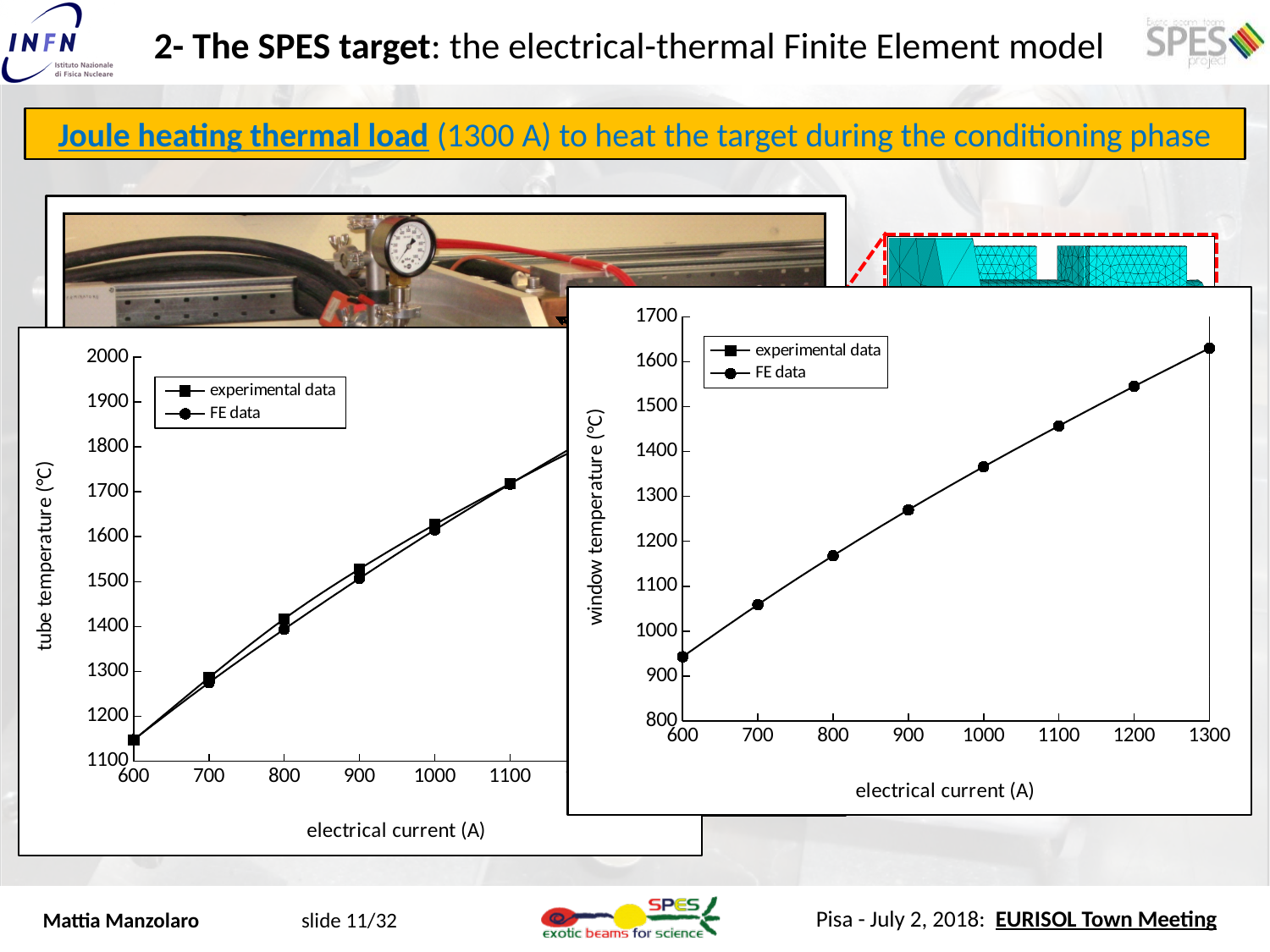
What are the two legend entries in the tube temperature chart on the left? experimental data, FE data In the window temperature chart on the right, is the FE data value at 1000 A greater or less than 1300? greater In the window temperature chart on the right, does the window temperature rise or fall as the electrical current increases? rise In the tube temperature chart on the left, does the tube temperature rise or fall as the electrical current increases? rise In the window temperature chart on the right, how many data points are plotted for the FE data series? 8 In the tube temperature chart on the left, is the experimental data value at 1100 A greater or less than 1800? less What is the label of the y axis of the chart on the right of the slide? window temperature (°C) In the window temperature chart on the right, is the FE data value at 600 A greater or less than 1000? less What kind of chart is the window temperature chart on the right of the slide? line chart How many series does the legend of the tube temperature chart on the left list? 2